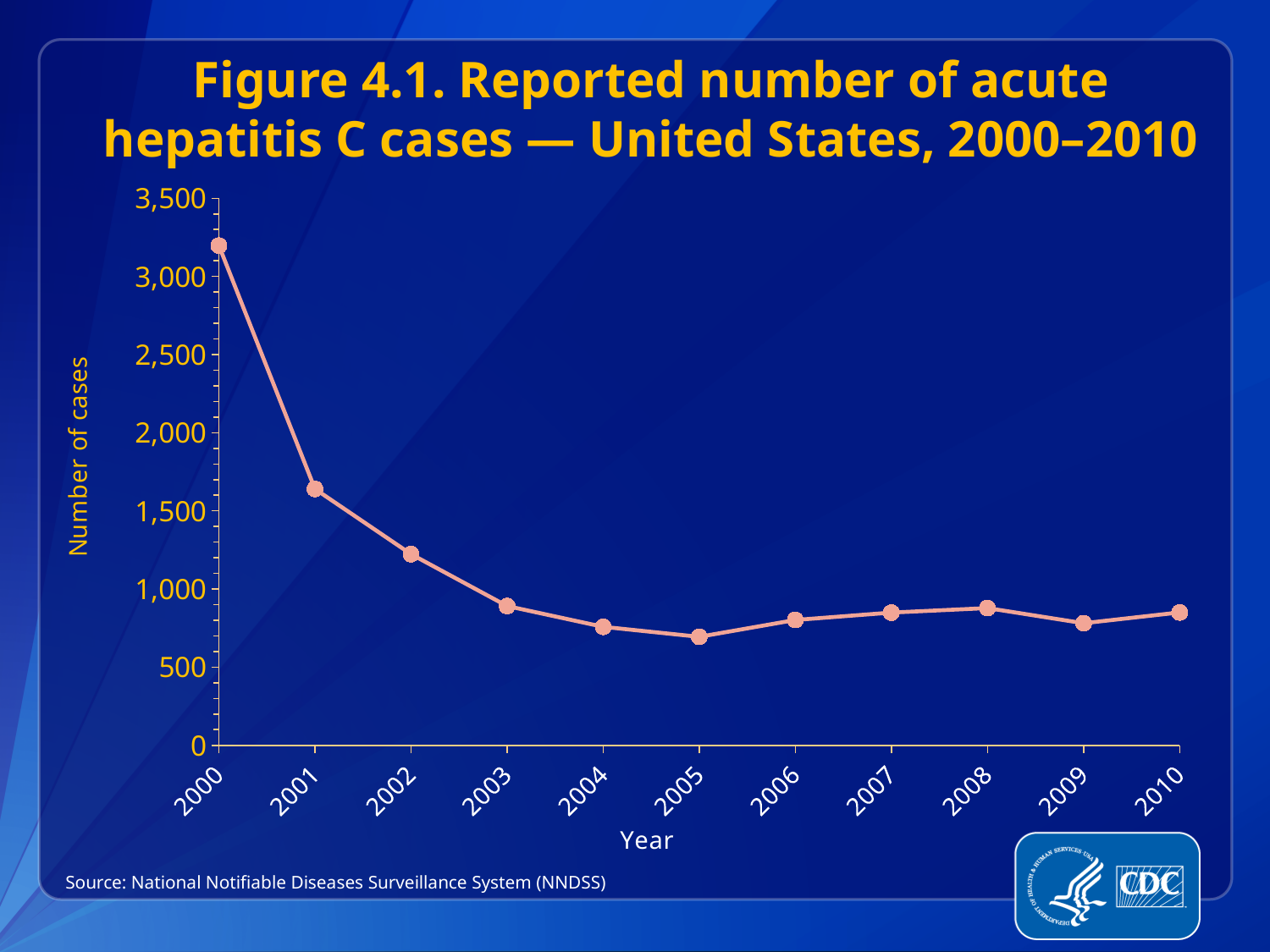
Do the reported cases rise or fall from 2000 to 2005? fall Is the value for 2000 greater or less than 3,000? greater What kind of chart is shown on the slide? line chart Which year has the lowest reported number of acute hepatitis C cases? 2005 Is the value for 2001 greater or less than 1,500? greater Which year has the highest reported number of acute hepatitis C cases? 2000 Which year has more reported cases, 2000 or 2001? 2000 What source is cited for the data in the chart? National Notifiable Diseases Surveillance System (NNDSS) Is the value for 2003 greater or less than 1,000? less How many years are plotted on the x axis? 11 What is the label of the y axis? Number of cases